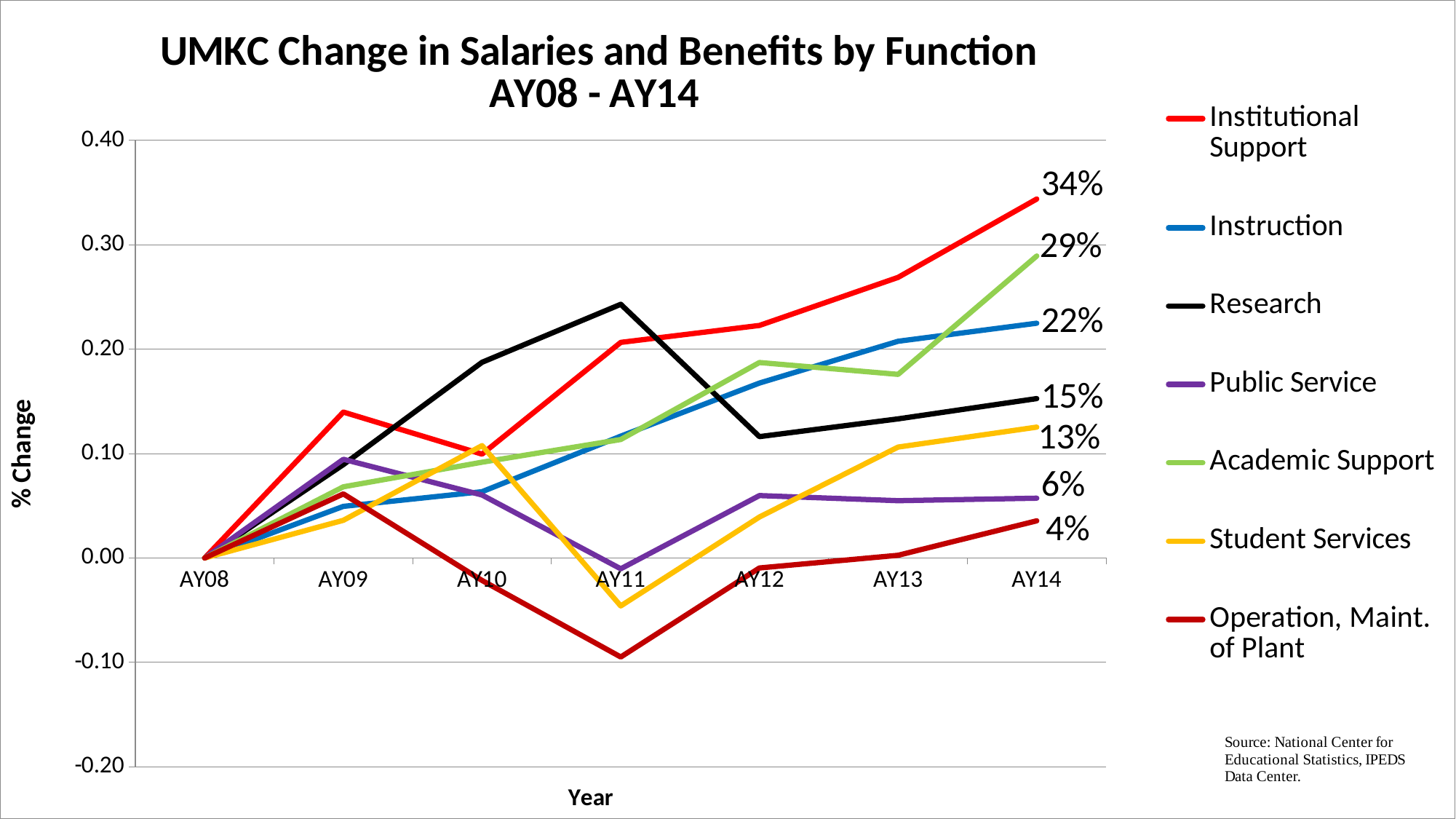
How many series does the legend list? 7 What is the labelled value for Academic Support at AY14? 29% What is the difference between the AY14 values for Instruction and Research? 7% What type of chart is shown on the slide? line chart Is the value for Research at AY11 greater or less than 0.20? greater Which function has the highest value at AY14? Institutional Support What is the labelled value for Student Services at AY14? 13% What is the y-axis label of the chart? % Change At AY14, which is larger: Public Service or Student Services? Student Services How many years are shown along the x axis? 7 What is the labelled value for Institutional Support at AY14? 34% Which function has the lowest value at AY14? Operation, Maint. of Plant